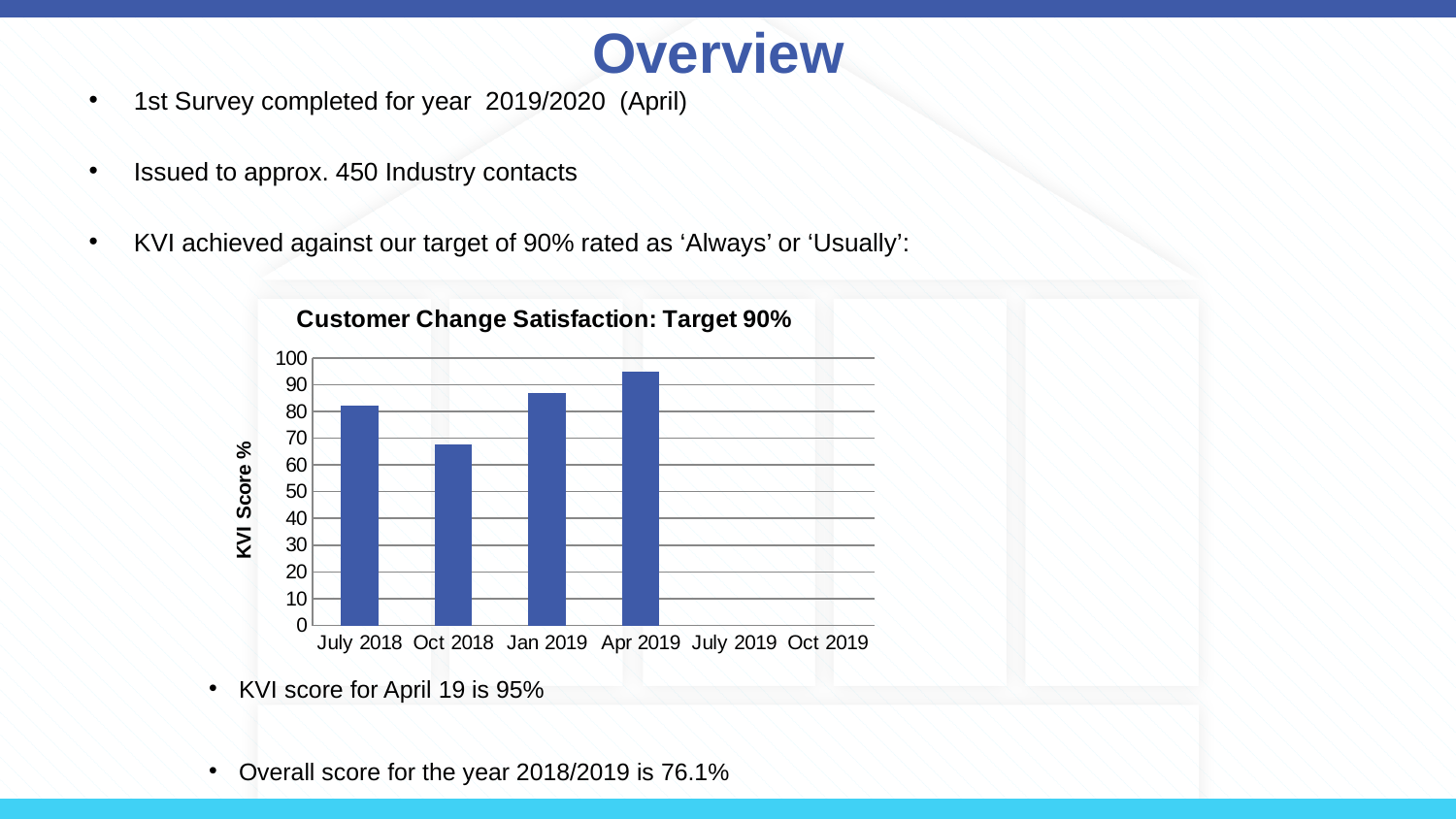
How many categories are shown on the x axis of the chart? 6 What is the KVI score for Apr 2019? 95% What is the label on the vertical axis of the chart? KVI Score % What type of chart is shown on the slide? Bar chart Is the value for Oct 2018 greater or less than 80? less Is the value for Apr 2019 greater or less than 90? greater How many bars are plotted in the chart? 4 Which is larger, the value for July 2018 or the value for Jan 2019? Jan 2019 Which category has the highest bar in the chart? Apr 2019 Do the values rise or fall from Oct 2018 to Apr 2019? Rise Which category with a plotted bar has the lowest value? Oct 2018 What is the title of the chart? Customer Change Satisfaction: Target 90%